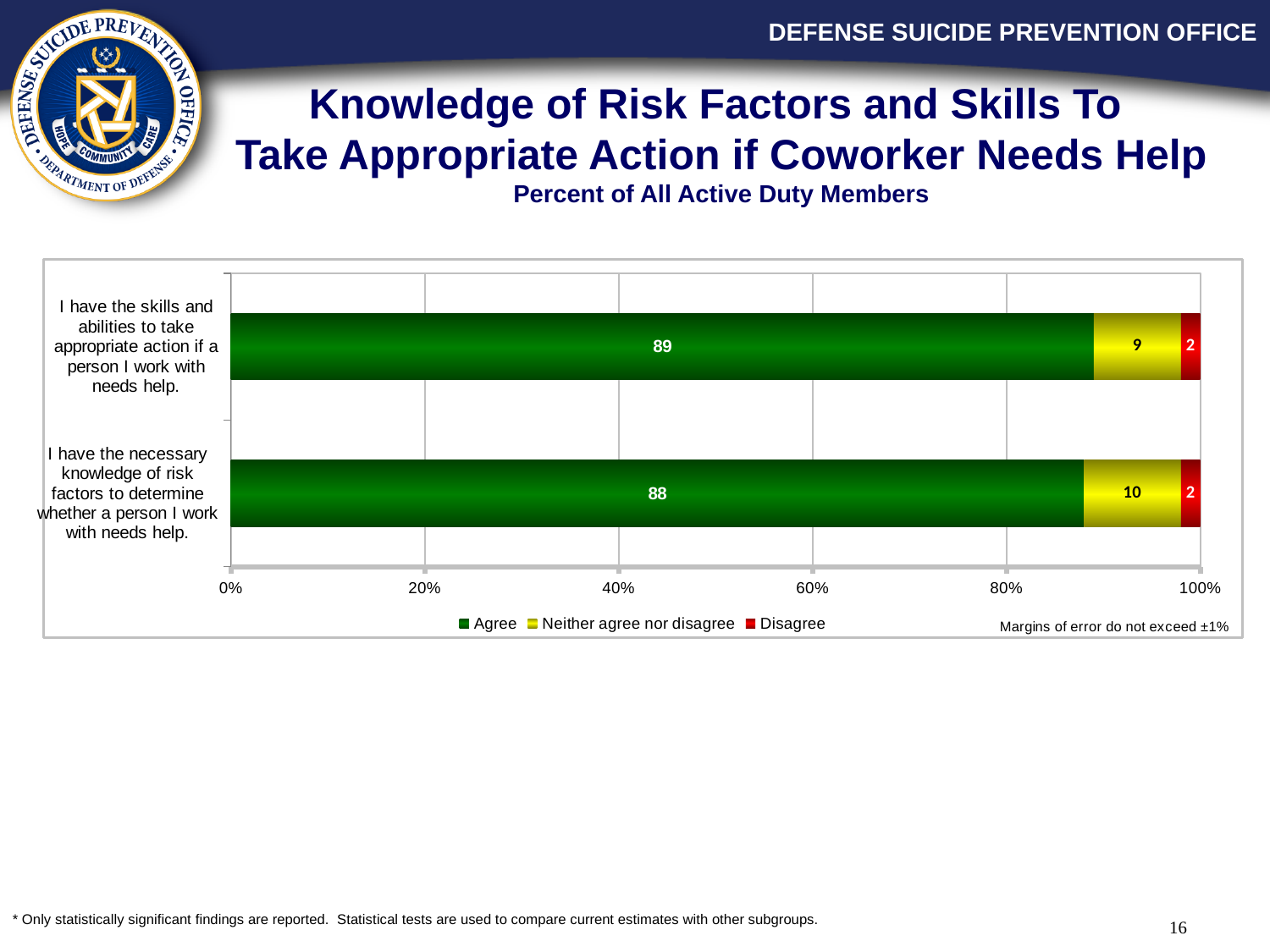
What is the Agree value for "I have the necessary knowledge of risk factors to determine whether a person I work with needs help"? 88 Which statement has the higher Agree value? I have the skills and abilities to take appropriate action if a person I work with needs help. What is the difference between the "Neither agree nor disagree" values of the two statements? 1 What is the total of the stacked bar for the statement about having the skills and abilities to take appropriate action? 100 Which legend entry is shown in red? Disagree What kind of chart is shown on the slide? Stacked bar chart What is the Agree value for "I have the skills and abilities to take appropriate action if a person I work with needs help"? 89 What is the Disagree value for the statement about having the skills and abilities to take appropriate action? 2 Is the Agree value for the statement about knowledge of risk factors greater or less than 80%? greater How many series does the legend list? 3 How many statements (categories) are shown in the chart? 2 What is the "Neither agree nor disagree" value for the statement about having the necessary knowledge of risk factors? 10